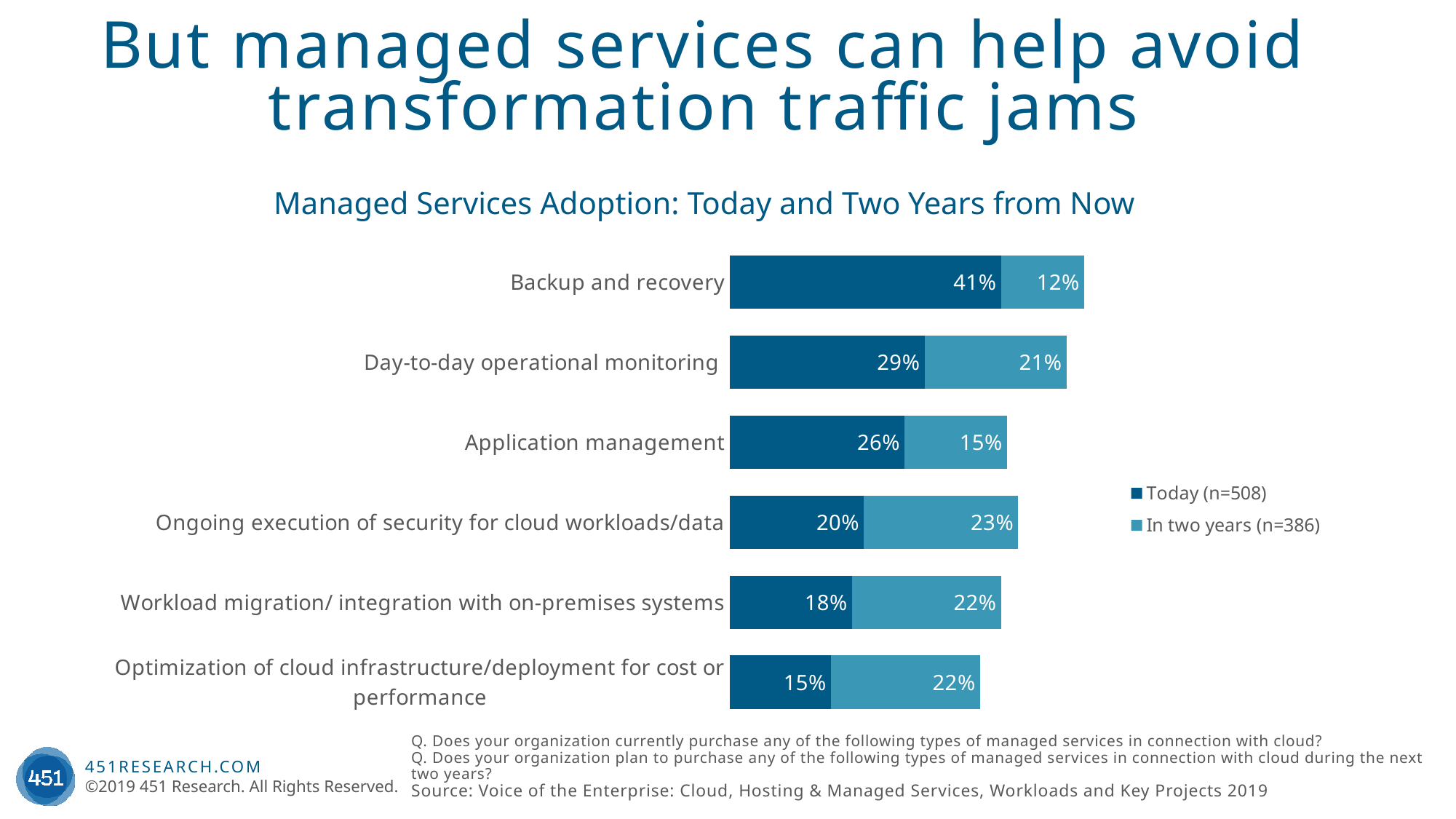
What is the title of the chart? Managed Services Adoption: Today and Two Years from Now What is the total of the stacked bar for Day-to-day operational monitoring? 50% What kind of chart is shown on the slide? Stacked bar chart What is the 'Today (n=508)' value for Optimization of cloud infrastructure/deployment for cost or performance? 15% What is the 'In two years (n=386)' value for Day-to-day operational monitoring? 21% What is the difference between the 'Today (n=508)' values for Backup and recovery and Application management? 15% Which category has the highest 'Today (n=508)' value? Backup and recovery Which is larger for Ongoing execution of security for cloud workloads/data: the 'Today (n=508)' value or the 'In two years (n=386)' value? In two years (n=386) What is the 'Today (n=508)' value for Backup and recovery? 41% How many series does the legend list? 2 How many categories are shown in the chart? 6 Which category has the lowest 'In two years (n=386)' value? Backup and recovery